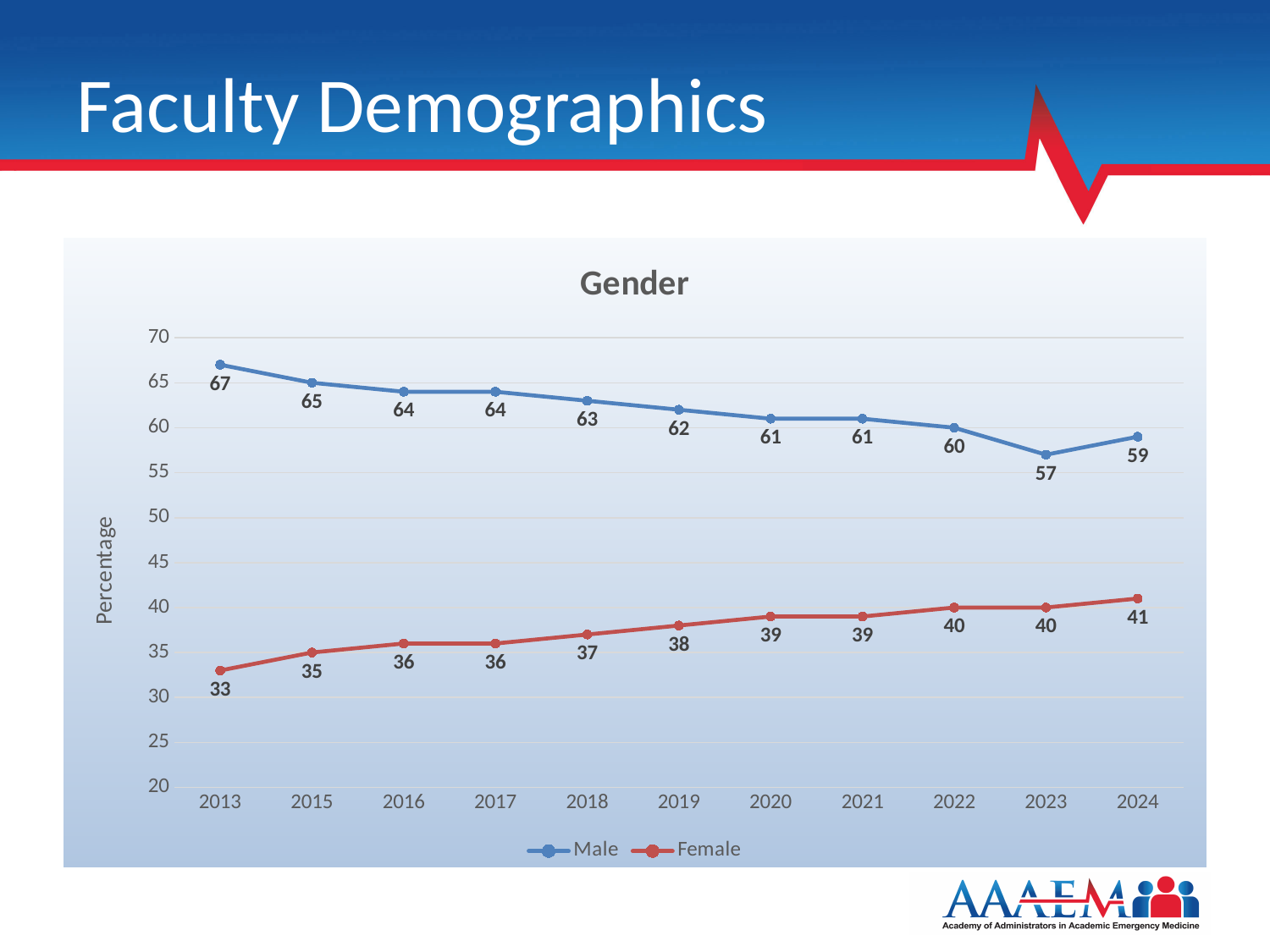
In which year is the Female series highest? 2024 What is the Male value for 2023? 57 What is the Female value for 2024? 41 How many years are shown on the x axis? 11 Does the Female series generally rise or fall from 2013 to 2024? Rise What is the Male value for 2013? 67 What kind of chart is shown? Line chart How many series does the legend list? 2 Which is larger in 2022, the Male value or the Female value? Male What is the difference between the Male and Female values in 2013? 34 What is the title of the chart? Gender In which year is the Male series lowest? 2023